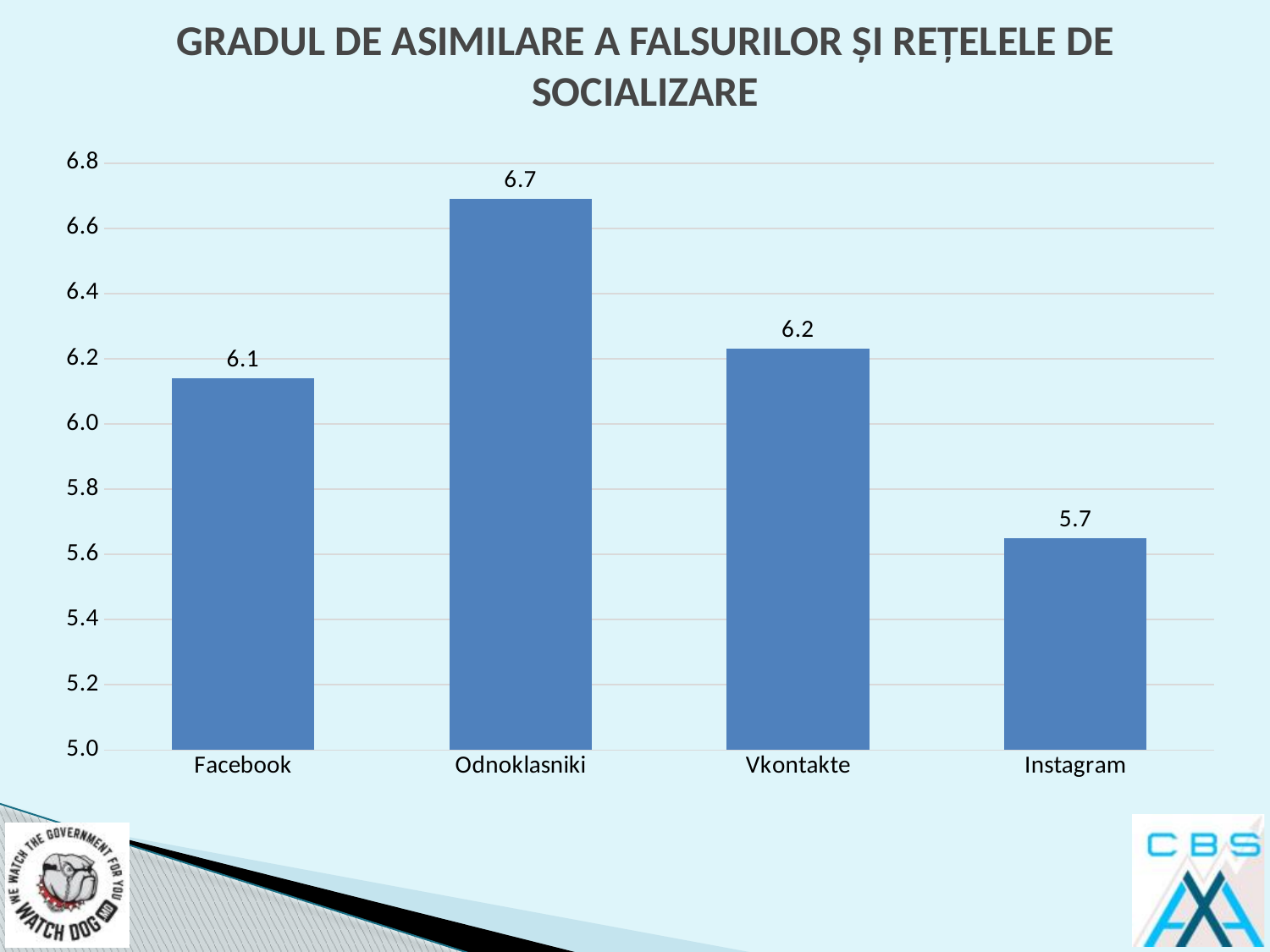
What is the value for Facebook? 6.1 Which social network has the lowest value? Instagram Is the value for Instagram greater or less than 6.0? less What is the value for Instagram? 5.7 What is the value for Odnoklasniki? 6.7 What kind of chart is shown on the slide? bar chart What is the title of the chart? GRADUL DE ASIMILARE A FALSURILOR ȘI REȚELELE DE SOCIALIZARE What is the difference between the values for Odnoklasniki and Instagram? 1.0 Which is larger, the value for Facebook or the value for Vkontakte? Vkontakte How many social networks are shown on the chart? 4 Which social network has the highest value? Odnoklasniki What is the value for Vkontakte? 6.2